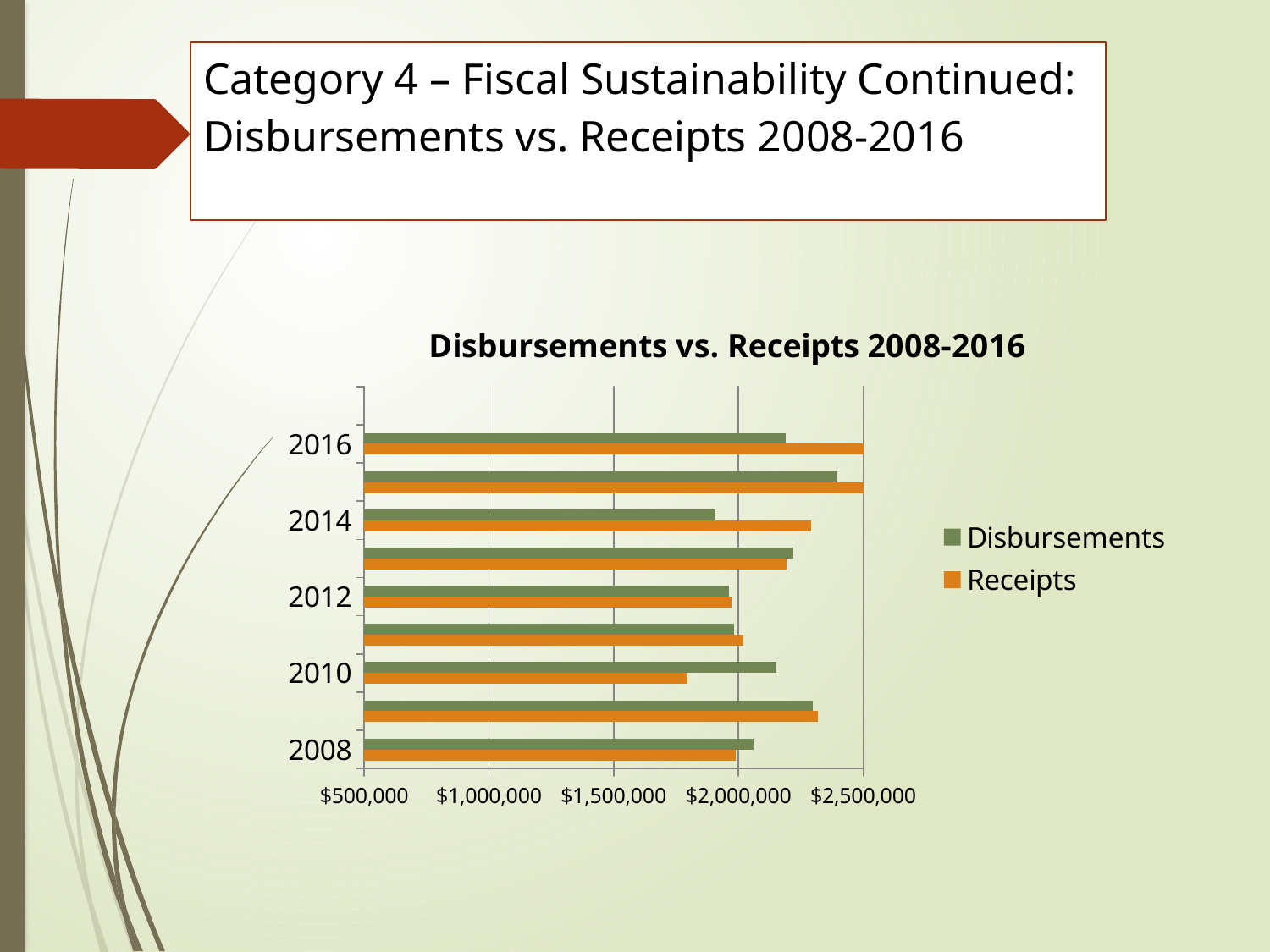
What is the title of the chart? Disbursements vs. Receipts 2008-2016 Which year has the lowest Receipts value? 2010 Is the Disbursements value for 2014 greater or less than $2,000,000? less How many years are plotted on the chart? 9 Is the Disbursements value for 2016 greater or less than $2,000,000? greater What kind of chart is shown on the slide? Bar chart In 2014, which is larger, Disbursements or Receipts? Receipts What are the two series shown in the legend? Disbursements and Receipts Is the Receipts value for 2014 greater or less than $2,000,000? greater How many series does the legend list? 2 In 2010, which is larger, Disbursements or Receipts? Disbursements